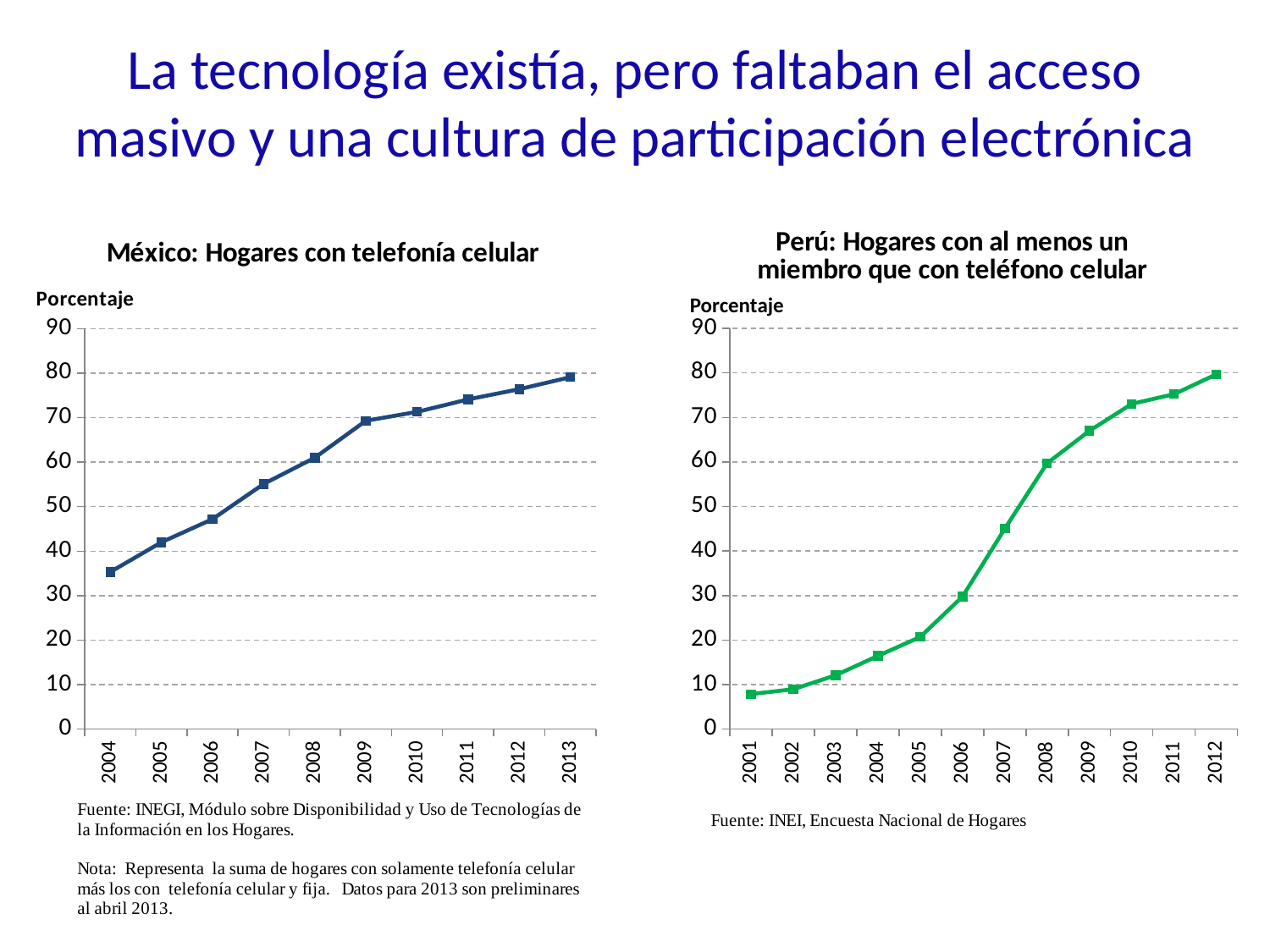
In the "Perú: Hogares con al menos un miembro que con teléfono celular" chart, is the value for 2007 greater or less than 40? greater What source is cited below the "Perú: Hogares con al menos un miembro que con teléfono celular" chart? INEI, Encuesta Nacional de Hogares What is the label shown above the vertical axis of the "Perú: Hogares con al menos un miembro que con teléfono celular" chart? Porcentaje In the "México: Hogares con telefonía celular" chart, which year has the highest value? 2013 In the "México: Hogares con telefonía celular" chart, which year has the larger value, 2006 or 2008? 2008 In the "México: Hogares con telefonía celular" chart, do the values rise or fall from 2004 to 2013? rise What kind of chart is the "México: Hogares con telefonía celular" chart? line chart In the "Perú: Hogares con al menos un miembro que con teléfono celular" chart, which year has the lowest value? 2001 In the "México: Hogares con telefonía celular" chart, how many years are plotted on the x axis? 10 In the "México: Hogares con telefonía celular" chart, is the value for 2004 greater or less than 40? less In the "Perú: Hogares con al menos un miembro que con teléfono celular" chart, is the value for 2008 greater or less than 50? greater In the "Perú: Hogares con al menos un miembro que con teléfono celular" chart, how many years are plotted on the x axis? 12